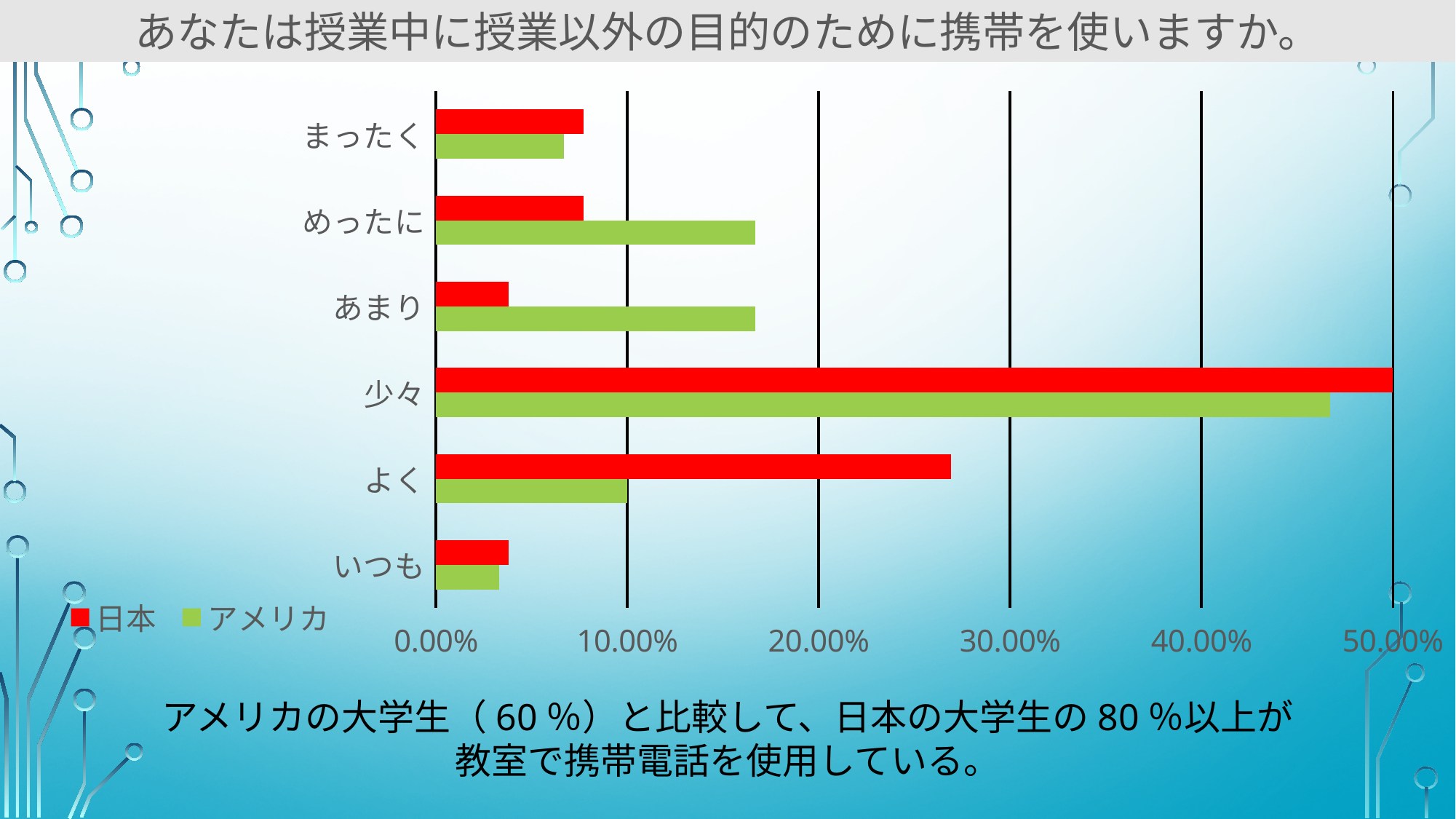
Which category has the highest value for 日本? 少々 Which colour represents the 日本 series in the chart? red For the よく category, which series has the larger value, 日本 or アメリカ? 日本 Is the value for アメリカ in the めったに category greater or less than 10.00%? greater What kind of chart is shown on the slide? bar chart Which category has the lowest value for アメリカ? いつも How many series does the legend list? 2 Is the value for 日本 in the よく category greater or less than 20.00%? greater Which category has the highest value for アメリカ? 少々 Is the value for 日本 in the あまり category greater or less than 10.00%? less For the あまり category, which series has the larger value, 日本 or アメリカ? アメリカ How many categories are shown on the vertical axis of the chart? 6